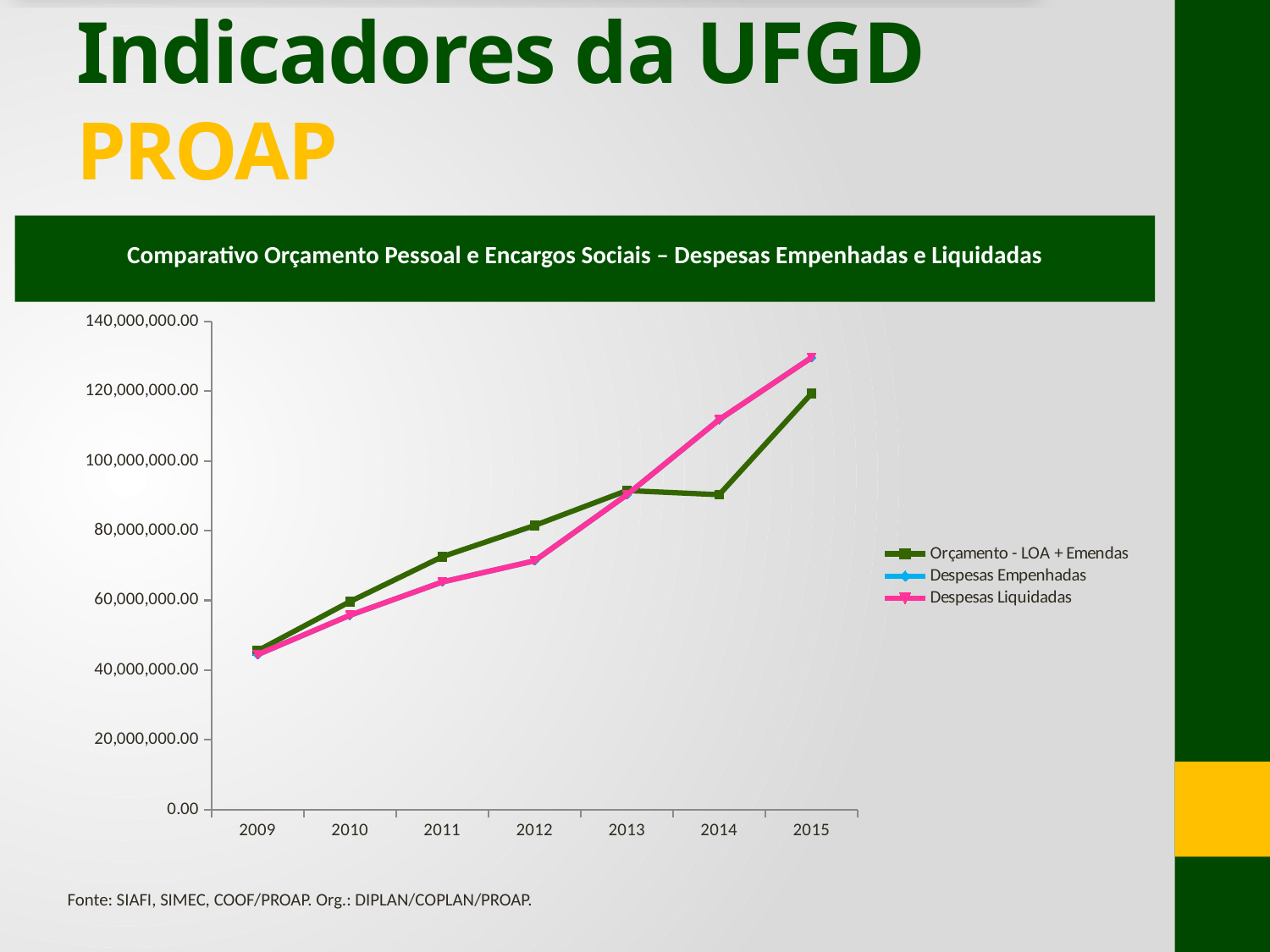
Which year has the highest value for Despesas Liquidadas? 2015 Is the value for Orçamento - LOA + Emendas in 2011 greater or less than 60,000,000.00? greater What kind of chart is shown on the slide? line chart Is the value for Orçamento - LOA + Emendas in 2014 greater or less than 100,000,000.00? less Is the value for Despesas Liquidadas in 2010 greater or less than 60,000,000.00? less How many series does the legend list? 3 In 2011, which is larger: Orçamento - LOA + Emendas or Despesas Liquidadas? Orçamento - LOA + Emendas In 2015, which is larger: Orçamento - LOA + Emendas or Despesas Liquidadas? Despesas Liquidadas Do the values for Despesas Liquidadas rise or fall from 2009 to 2015? rise How many years are shown on the x axis? 7 Which year has the lowest value for Orçamento - LOA + Emendas? 2009